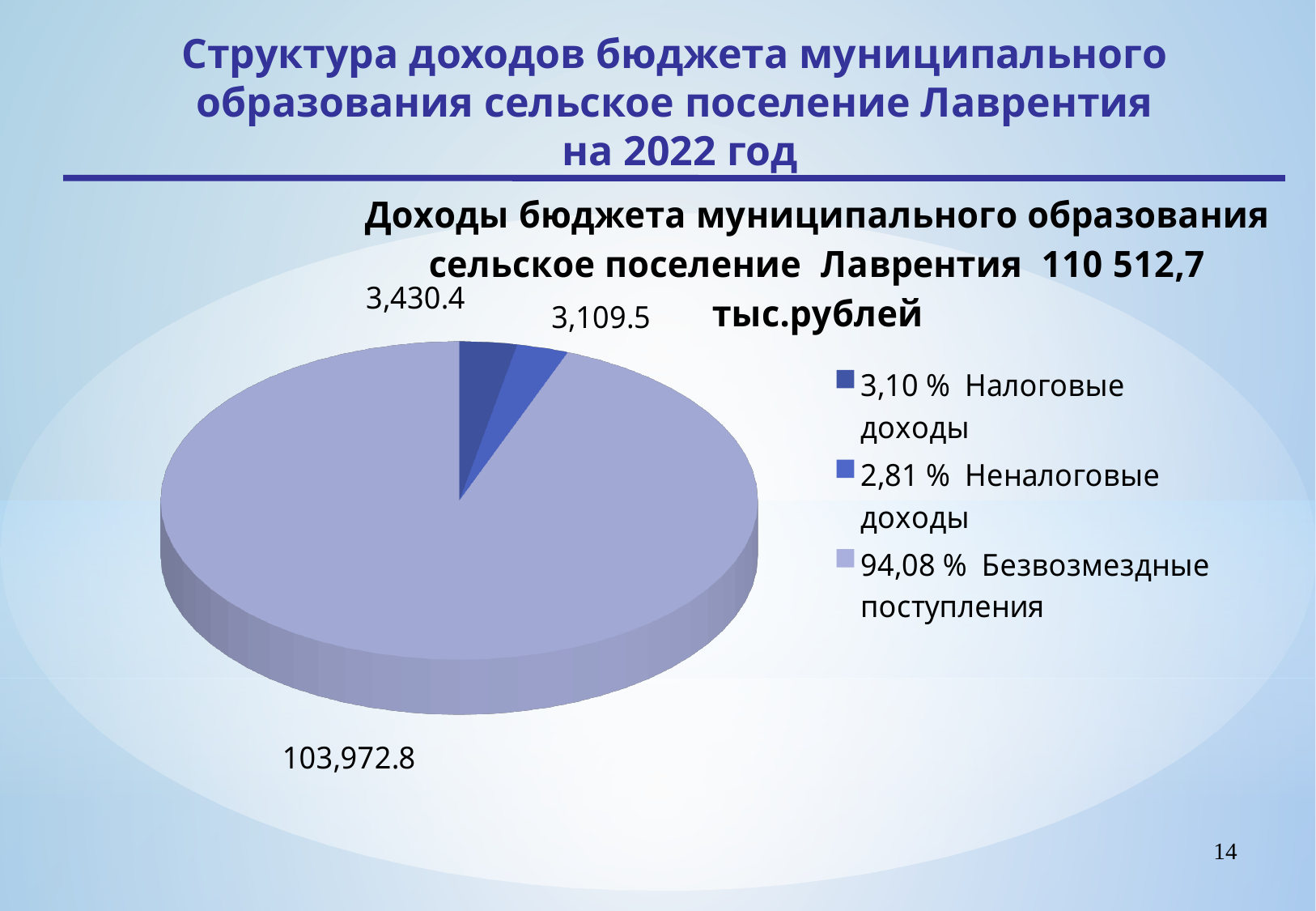
How many slices does the pie chart have? 3 What is the difference between the values for Налоговые доходы and Неналоговые доходы? 320.9 What is the value shown for Безвозмездные поступления? 103,972.8 What total amount of budget revenue is stated in the chart title? 110 512,7 тыс.рублей How many entries does the legend of the pie chart list? 3 What share of the pie does Безвозмездные поступления represent, according to the legend? 94,08 % Which category has the largest slice of the pie? Безвозмездные поступления What share of the pie does Налоговые доходы represent, according to the legend? 3,10 % What is the value shown for Налоговые доходы? 3,430.4 What type of chart is shown on the slide? Pie chart Which category has the smallest slice of the pie? Неналоговые доходы What is the value shown for Неналоговые доходы? 3,109.5